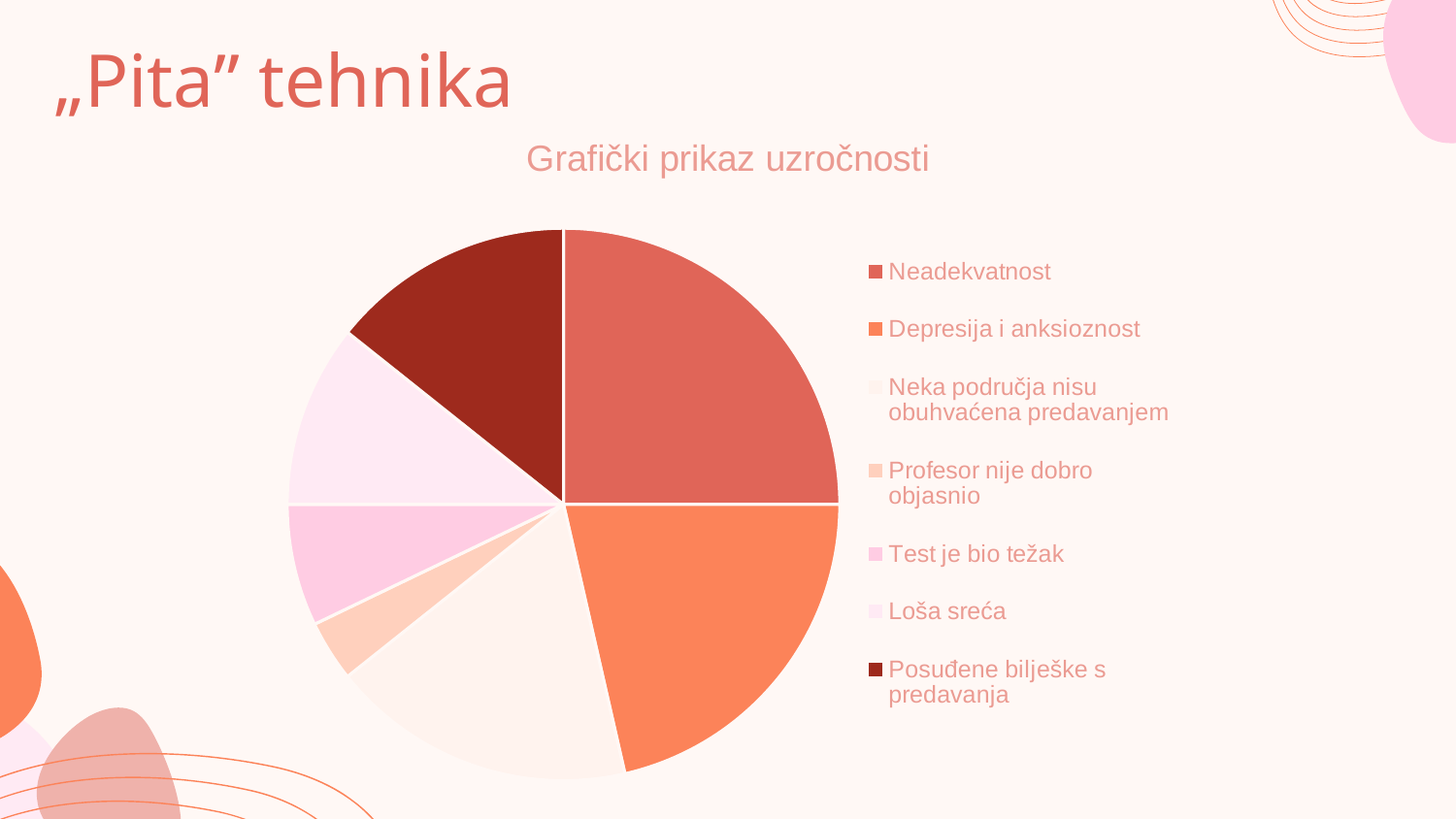
What kind of chart is shown on the slide? pie chart How many entries does the legend list? 7 How many slices does the pie chart have? 7 Which slice is larger: Neka područja nisu obuhvaćena predavanjem or Test je bio težak? Neka područja nisu obuhvaćena predavanjem What is the title of the chart? Grafički prikaz uzročnosti Which slice is larger: Depresija i anksioznost or Profesor nije dobro objasnio? Depresija i anksioznost Which category has the largest slice of the pie? Neadekvatnost Which slice is larger: Neadekvatnost or Test je bio težak? Neadekvatnost Which category has the smallest slice of the pie? Profesor nije dobro objasnio Which legend entry is shown in the darkest red colour? Posuđene bilješke s predavanja